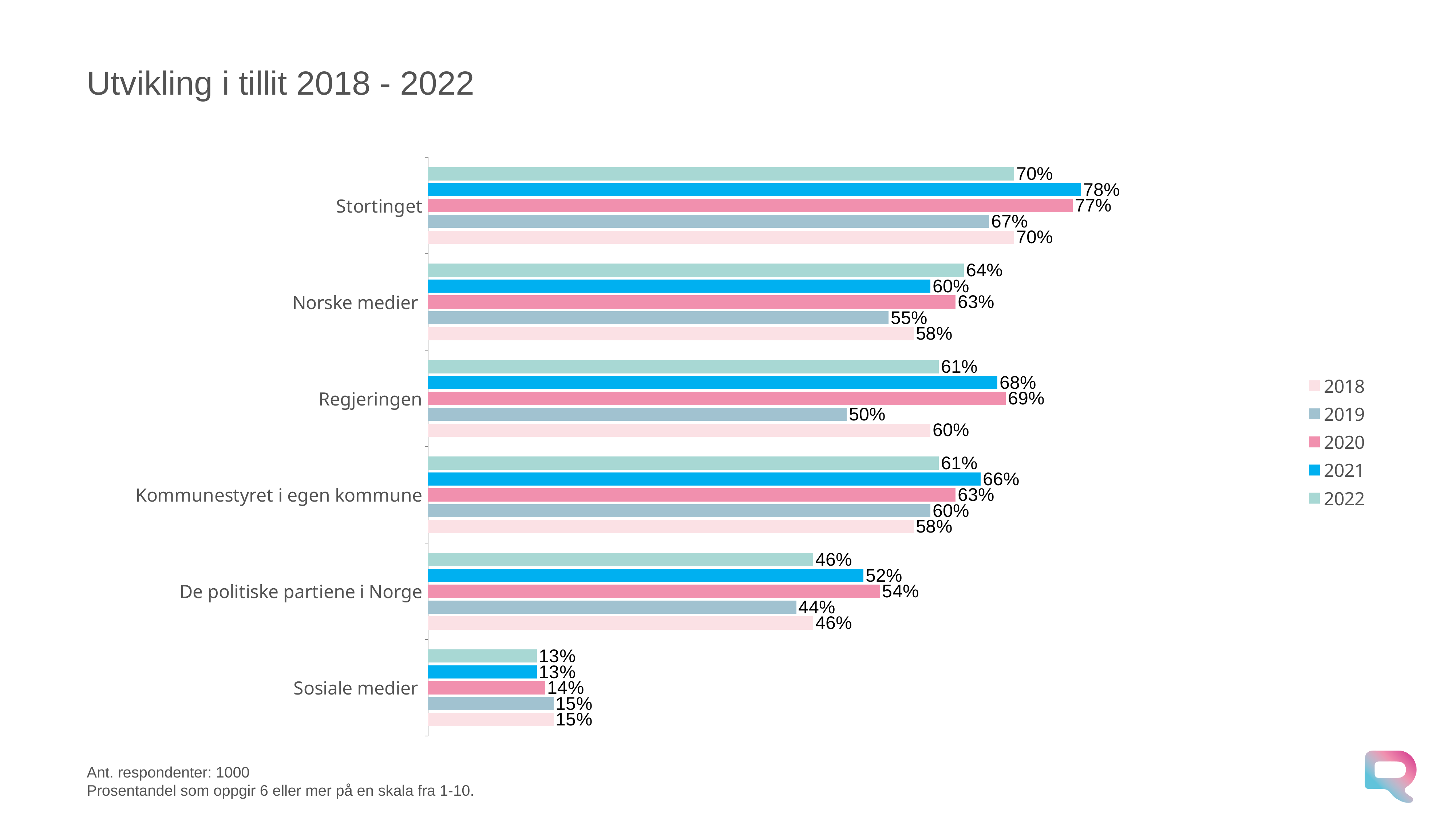
How many categories are shown on the chart? 6 What is the difference between the 2020 and 2019 values for De politiske partiene i Norge? 10% Which category has the highest value in 2022? Stortinget What is the value for Sosiale medier in 2022? 13% What is the title of the chart? Utvikling i tillit 2018 - 2022 What is the difference between the 2021 and 2022 values for Stortinget? 8% Which category has the lowest value in 2020? Sosiale medier What is the value for Stortinget in 2021? 78% How many series does the legend list? 5 Which is larger for Norske medier: the 2022 value or the 2019 value? 2022 What kind of chart is shown on the slide? Bar chart What is the value for Regjeringen in 2019? 50%